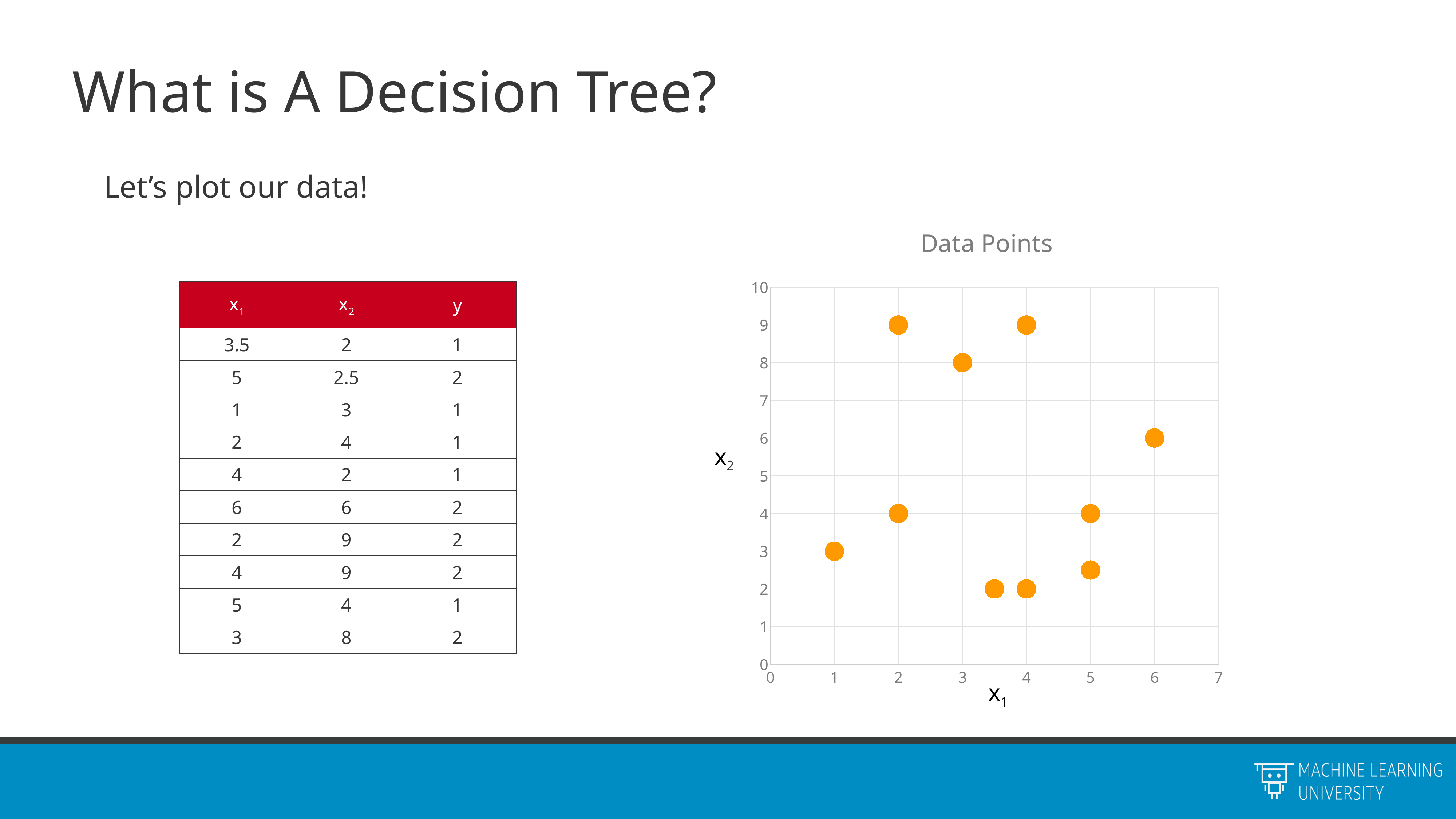
In the "Data Points" chart, what is the difference in x2 between the point at x1 = 3 and the point at x1 = 1? 5 What is the lowest x2 value among the plotted points in the "Data Points" chart? 2 In the "Data Points" chart, which point has the larger x2 value: the point at x1 = 1 or the point at x1 = 6? the point at x1 = 6 What is the title of the chart on the slide? Data Points What is the largest x1 value among the plotted points in the "Data Points" chart? 6 In the "Data Points" chart, what is the x1 value of the point at x2 = 8? 3 In the "Data Points" chart, is the x2 value of the point at x1 = 6 greater or less than 5? greater In the "Data Points" chart, what is the x2 value of the point at x1 = 6? 6 In the "Data Points" chart, what is the x2 value of the point at x1 = 1? 3 What kind of chart is the "Data Points" chart? scatter chart How many data points are plotted in the "Data Points" chart? 10 What is the highest x2 value among the plotted points in the "Data Points" chart? 9